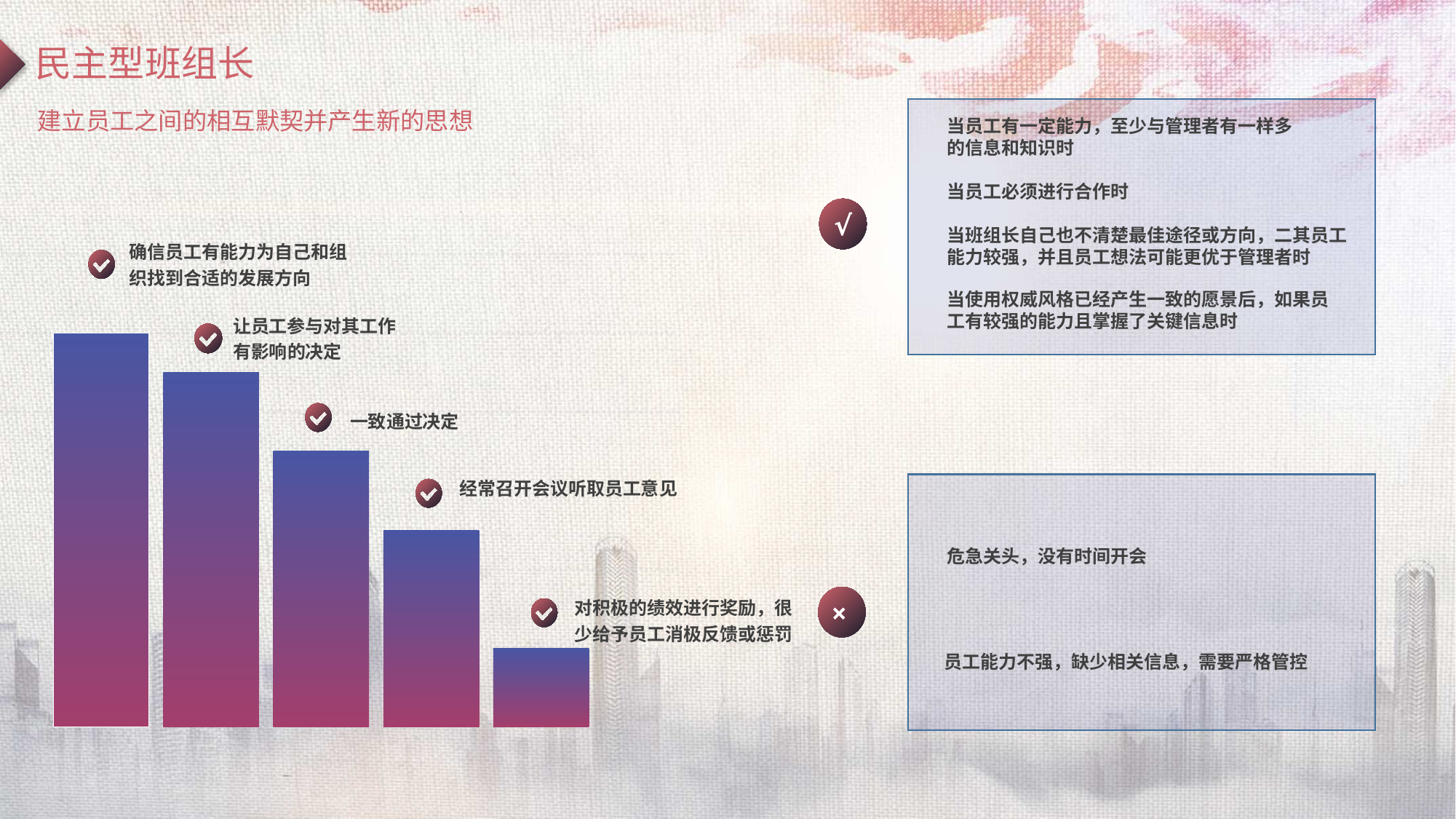
Which labelled item has the tallest bar? 确信员工有能力为自己和组织找到合适的发展方向 How many bars does the chart contain? 5 Which bar is taller: the one for 让员工参与对其工作有影响的决定 or the one for 对积极的绩效进行奖励，很少给予员工消极反馈或惩罚? 让员工参与对其工作有影响的决定 Which bar is taller: the one for 一致通过决定 or the one for 经常召开会议听取员工意见? 一致通过决定 Which bar is taller: the first bar (确信员工有能力为自己和组织找到合适的发展方向) or the second bar (让员工参与对其工作有影响的决定)? 确信员工有能力为自己和组织找到合适的发展方向 What is the label of the third bar from the left? 一致通过决定 Does the chart display numeric data labels or a value axis? No What kind of chart is shown on the slide? Bar chart Which labelled item has the shortest bar? 对积极的绩效进行奖励，很少给予员工消极反馈或惩罚 Do the bar heights rise or fall from left to right? Fall